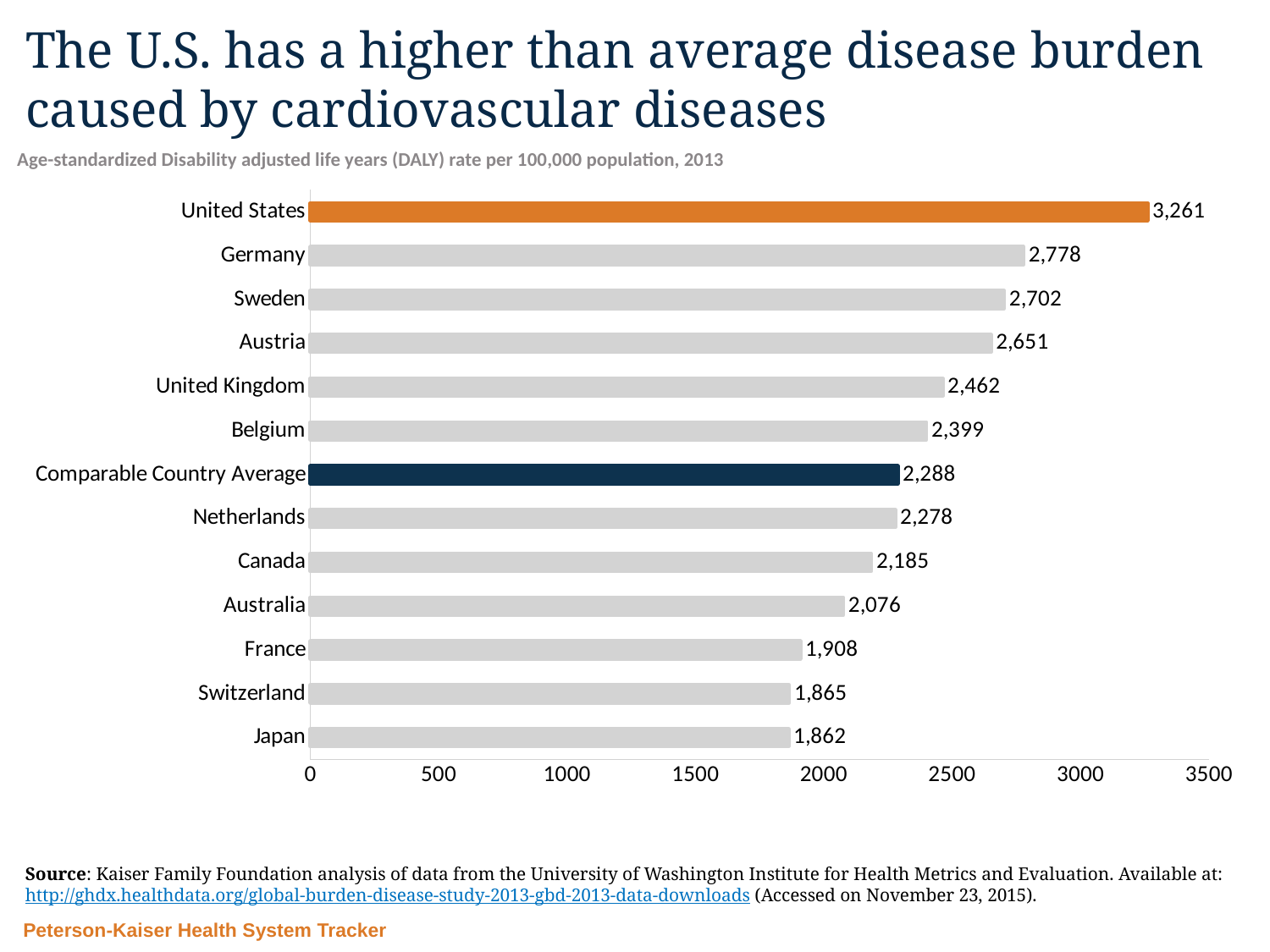
Which country has the highest DALY rate? United States What kind of chart is shown on the slide? bar chart What is the DALY rate for the United States? 3,261 What is the value shown for the Comparable Country Average? 2,288 How many bars are shown in the chart? 13 Which has a higher value, Canada or Australia? Canada What colour is the bar for the United States? orange What is the difference between the United States value and the Comparable Country Average? 973 Is the value for Belgium greater or less than 2500? less What is the difference between Germany and Sweden? 76 Which country has the lowest DALY rate? Japan What is the value for Japan? 1,862